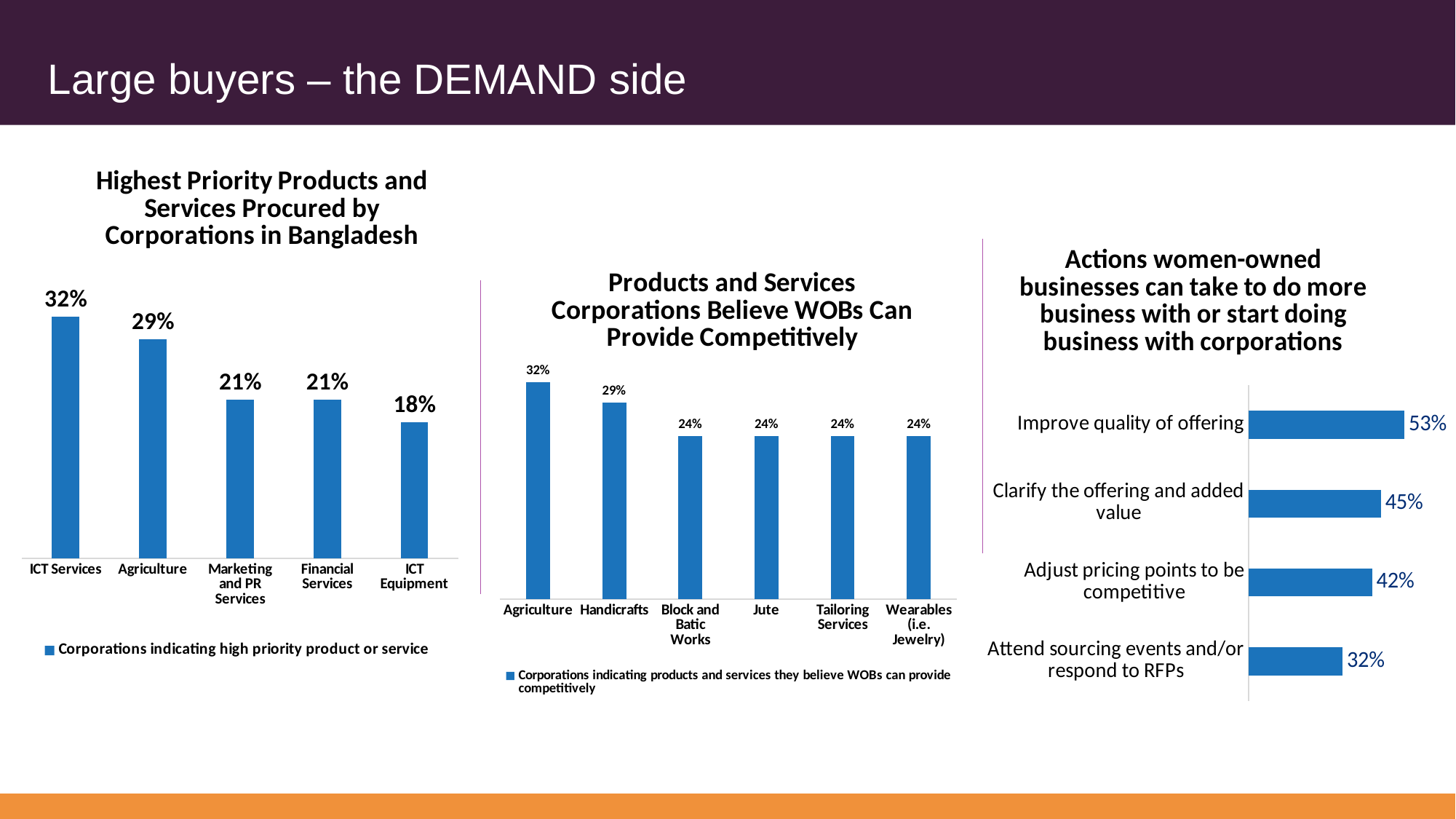
In the 'Highest Priority Products and Services Procured by Corporations in Bangladesh' chart, how many categories are shown? 5 In the 'Actions women-owned businesses can take' chart, what is the difference between 'Improve quality of offering' and 'Attend sourcing events and/or respond to RFPs'? 21% In the 'Products and Services Corporations Believe WOBs Can Provide Competitively' chart, which is larger, Agriculture or Jute? Agriculture In the 'Products and Services Corporations Believe WOBs Can Provide Competitively' chart, what is the value for Handicrafts? 29% In the 'Highest Priority Products and Services Procured by Corporations in Bangladesh' chart, what is the difference between ICT Services and ICT Equipment? 14% In the 'Products and Services Corporations Believe WOBs Can Provide Competitively' chart, which category has the highest value? Agriculture In the 'Highest Priority Products and Services Procured by Corporations in Bangladesh' chart, what is the value for Agriculture? 29% In the 'Actions women-owned businesses can take' chart, what is the value for 'Adjust pricing points to be competitive'? 42% In the 'Actions women-owned businesses can take' chart, which action has the highest value? Improve quality of offering In the 'Highest Priority Products and Services Procured by Corporations in Bangladesh' chart, which category has the lowest value? ICT Equipment What type of chart is the 'Actions women-owned businesses can take' chart? Bar chart In the 'Products and Services Corporations Believe WOBs Can Provide Competitively' chart, how many categories are shown? 6